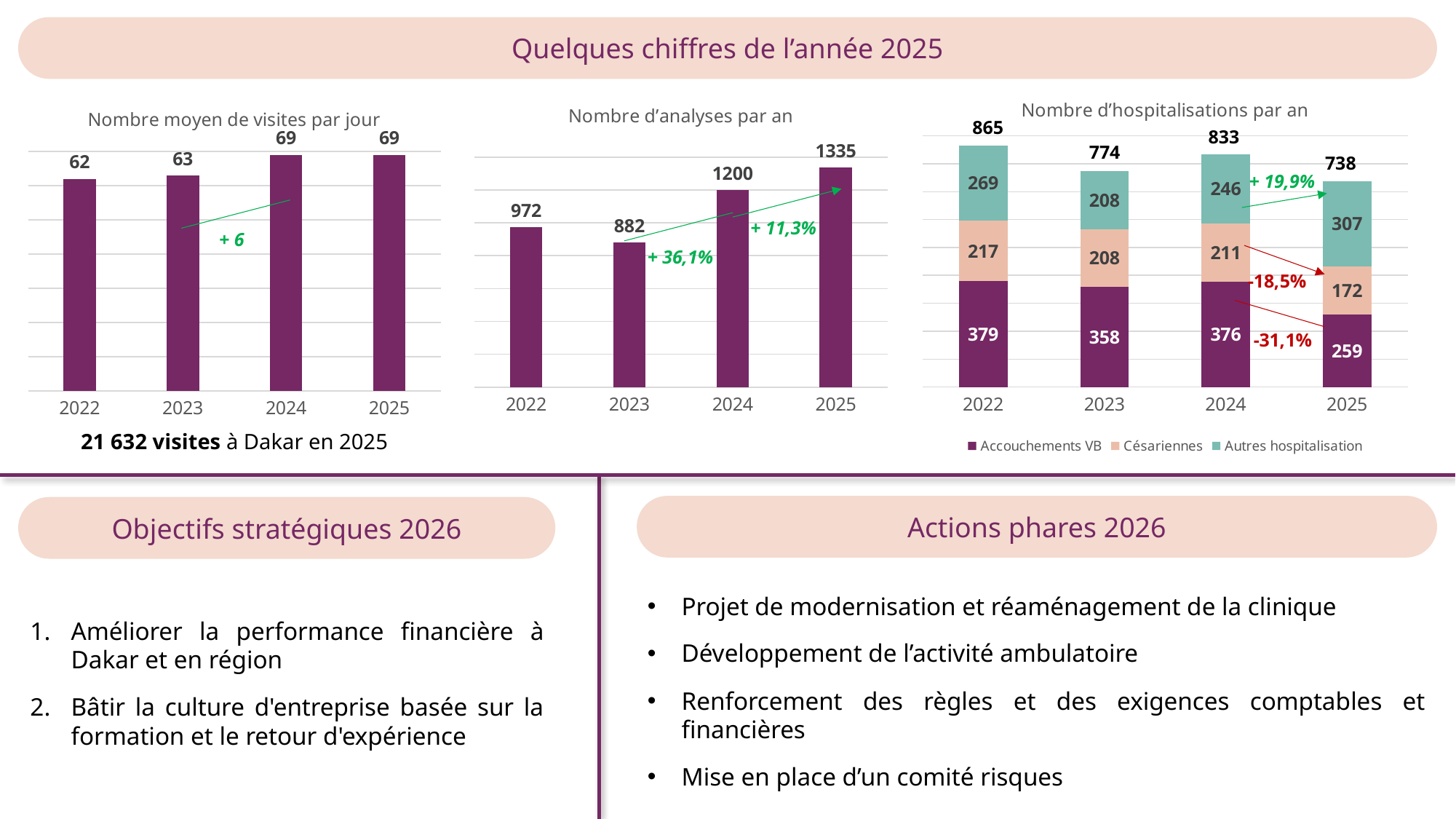
How many years are shown on the x axis of the chart 'Nombre moyen de visites par jour'? 4 In the chart 'Nombre d'analyses par an', what is the difference between the 2024 and 2022 values? 228 In the chart 'Nombre moyen de visites par jour', what is the value for 2023? 63 In the chart 'Nombre d'analyses par an', what is the value for 2025? 1335 In the chart 'Nombre moyen de visites par jour', which year has the lowest value? 2022 What kind of chart is 'Nombre d'hospitalisations par an'? Stacked bar chart In the chart 'Nombre d'analyses par an', which is larger, the value for 2022 or the value for 2023? 2022 In the chart 'Nombre d'hospitalisations par an', what is the value of Césariennes in 2025? 172 In the chart 'Nombre d'hospitalisations par an', what is the total of the stacked bar for 2023? 774 How many series does the legend of the chart 'Nombre d'hospitalisations par an' list? 3 In the chart 'Nombre d'hospitalisations par an', which year has the highest total? 2022 In the chart 'Nombre d'analyses par an', which year has the lowest value? 2023